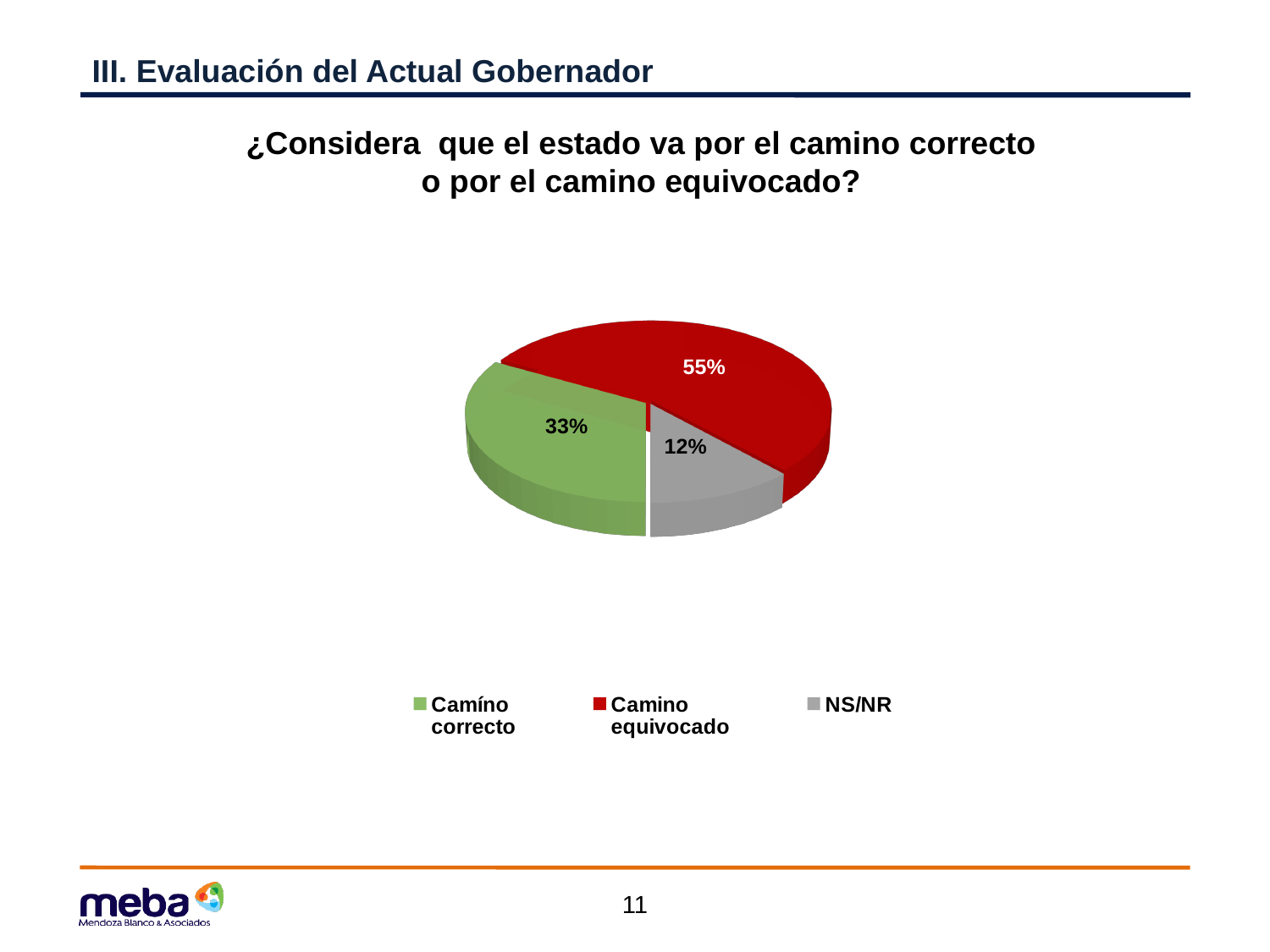
How many entries does the legend list? 3 Which is larger, the share for "Camíno correcto" or the share for "NS/NR"? Camíno correcto How many slices does the pie chart have? 3 Which response has the largest share of the pie? Camino equivocado What colour is the slice for "Camino equivocado"? red What percentage of respondents answered "NS/NR"? 12% What is the difference in percentage points between "Camino equivocado" and "Camíno correcto"? 22 What percentage of respondents answered "Camíno correcto"? 33% What kind of chart is shown on the slide? pie chart What percentage of respondents answered "Camino equivocado"? 55% What colour is the slice for "NS/NR"? grey Which response has the smallest share of the pie? NS/NR